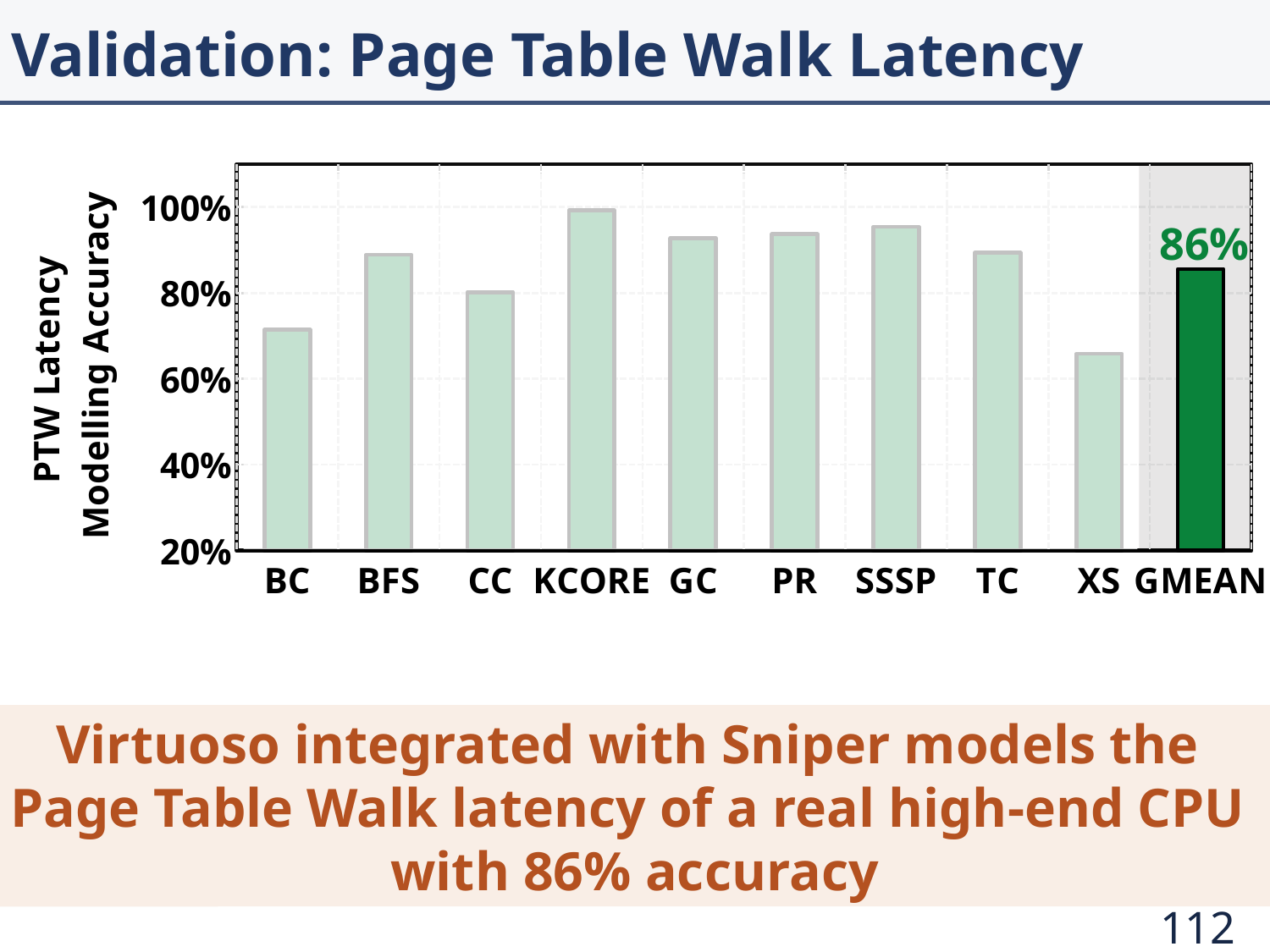
What kind of chart is shown on the slide? Bar chart Is the value for BC greater or less than 80%? less Which workload has the highest PTW latency modelling accuracy? KCORE Is the value for KCORE greater or less than 80%? greater How many bars are shown on the chart, including GMEAN? 10 Which workload has the lowest PTW latency modelling accuracy? XS Is the value for CC greater or less than 60%? greater Which has a higher PTW latency modelling accuracy, KCORE or XS? KCORE What is the PTW latency modelling accuracy shown for GMEAN? 86% What is the label of the vertical axis? PTW Latency Modelling Accuracy Which has a higher PTW latency modelling accuracy, BC or BFS? BFS